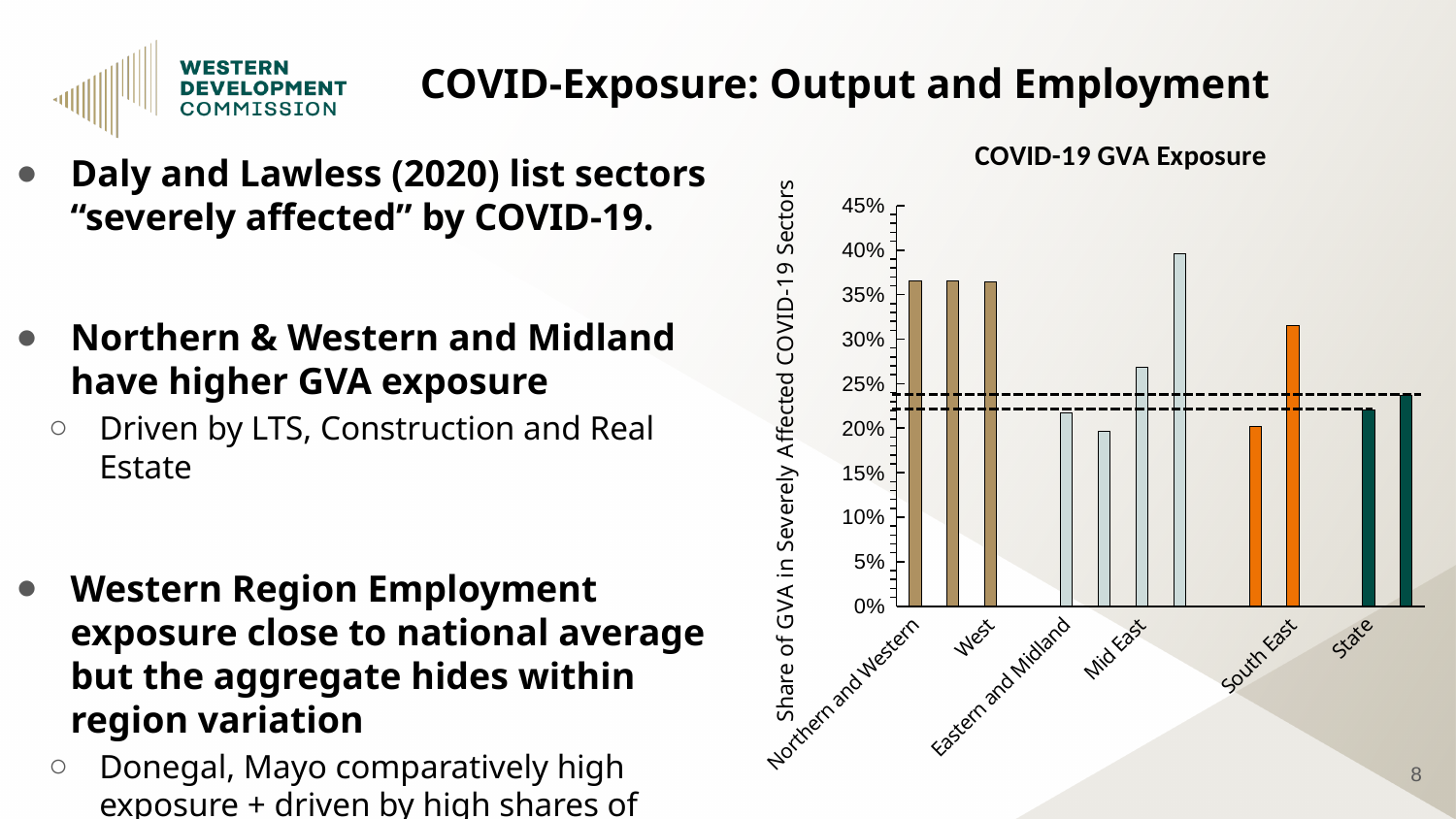
Is the value for Northern and Western greater or less than 30%? greater Is the value for Mid East greater or less than 25%? greater Is the value for Eastern and Midland greater or less than 25%? less Which has the larger value, Mid East or Eastern and Midland? Mid East What is the title of the chart? COVID-19 GVA Exposure What is the label on the vertical axis of the chart? Share of GVA in Severely Affected COVID-19 Sectors Which has the larger value, Northern and Western or South East? Northern and Western How many category labels are shown on the x axis of the chart? 6 What kind of chart is shown on the slide? bar chart